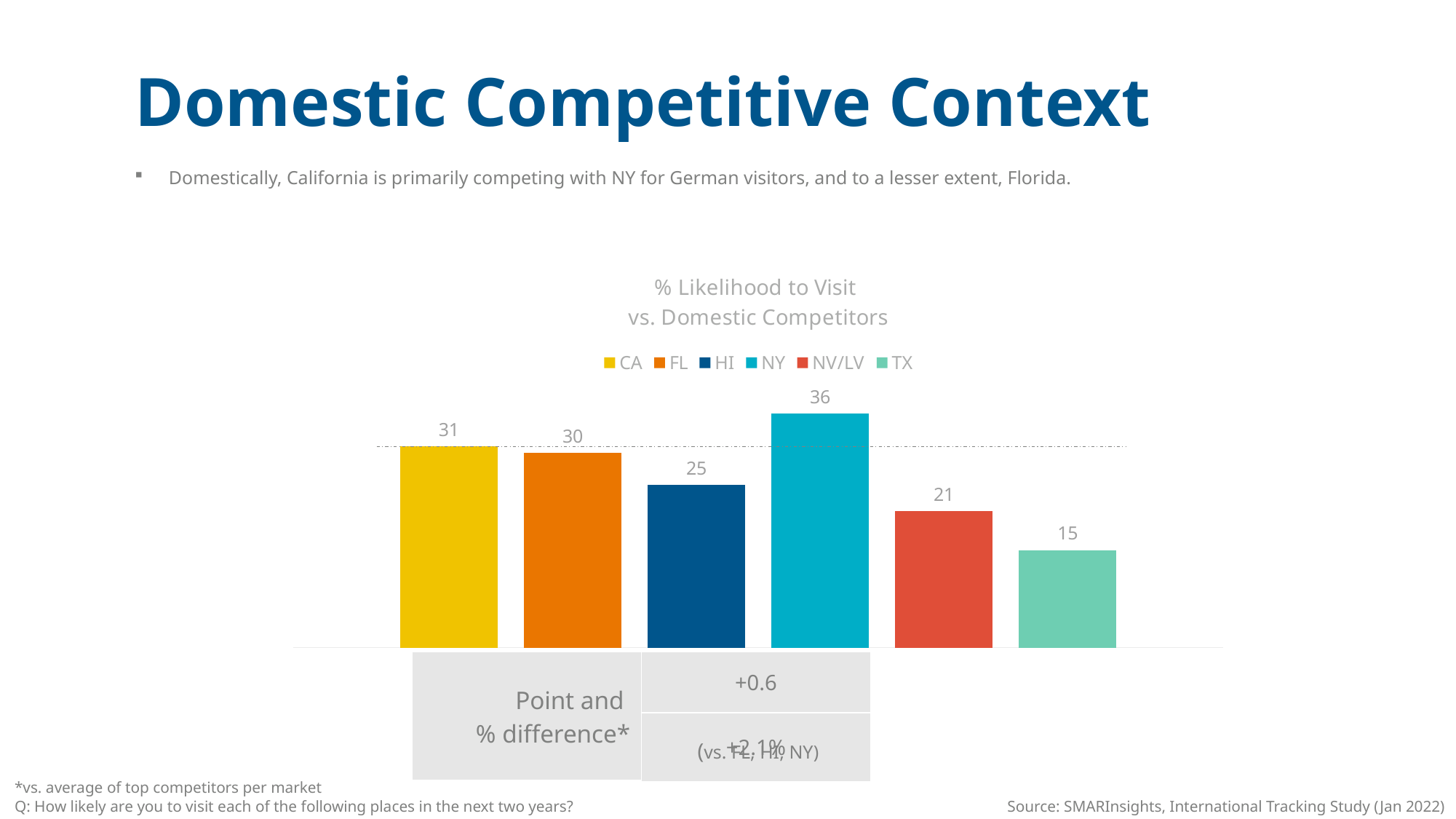
Which state has the lowest % likelihood to visit? TX How many states are plotted in the chart? 6 What is the value shown for TX? 15 What is the difference between the values for NY and CA? 5 What is the % likelihood to visit value for NY? 36 Which has a larger value, FL or HI? FL What type of chart is shown on the slide? Bar chart What is the value shown for NV/LV? 21 What is the % likelihood to visit value for CA? 31 How many entries does the legend list? 6 What is the difference between the values for HI and TX? 10 Which state has the highest % likelihood to visit? NY